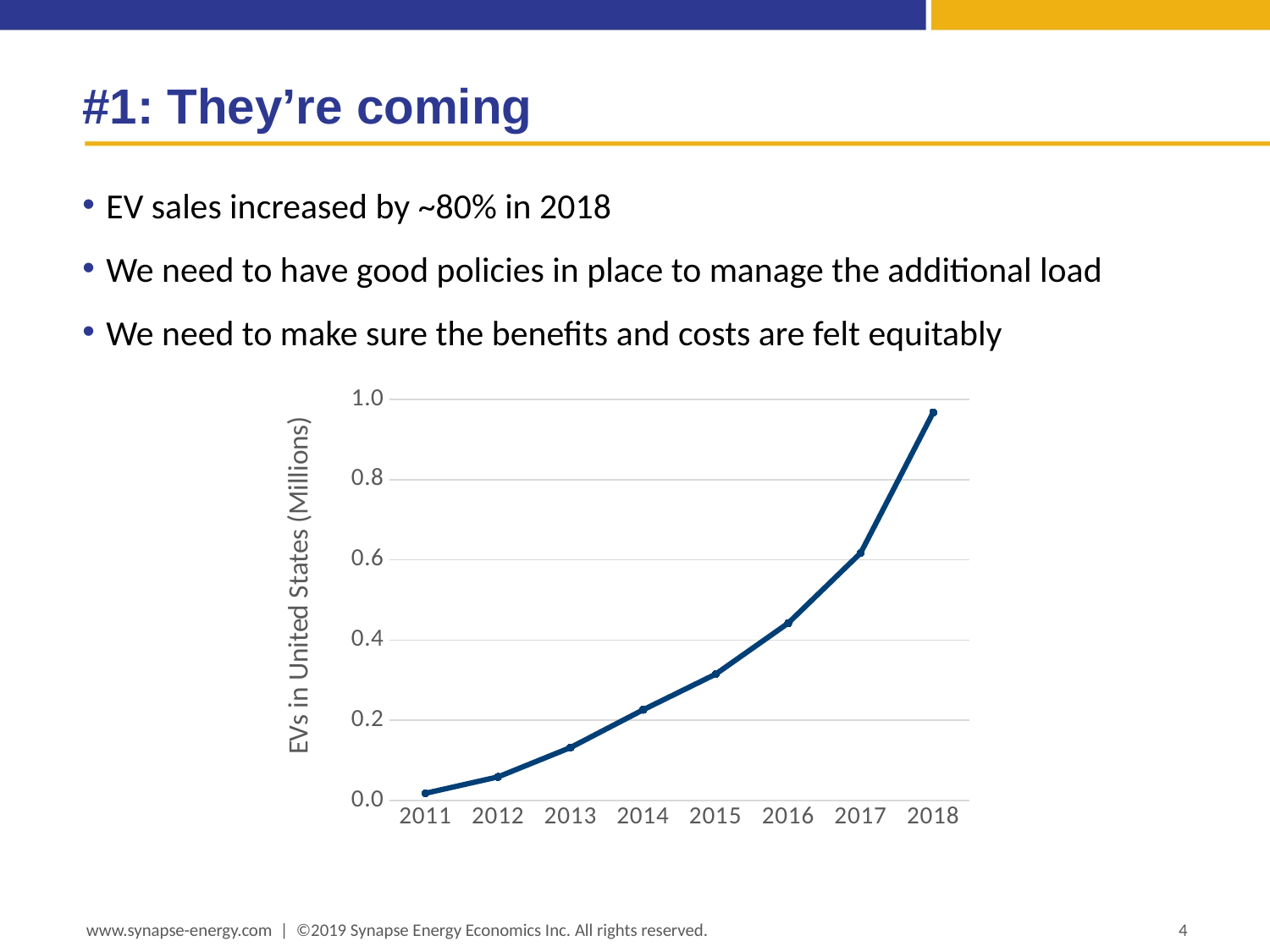
Is the value for 2017 greater or less than 0.4? greater Is the value for 2016 greater or less than 0.6? less What is the label on the vertical axis of the chart? EVs in United States (Millions) Is the value for 2018 greater or less than 0.8? greater How many years are plotted on the x axis of the chart? 8 Which year has the highest value in the chart? 2018 Do the values in the chart rise or fall from 2011 to 2018? rise Which year has the larger value, 2014 or 2017? 2017 What kind of chart is shown on the slide? line chart Which year has the lowest value in the chart? 2011